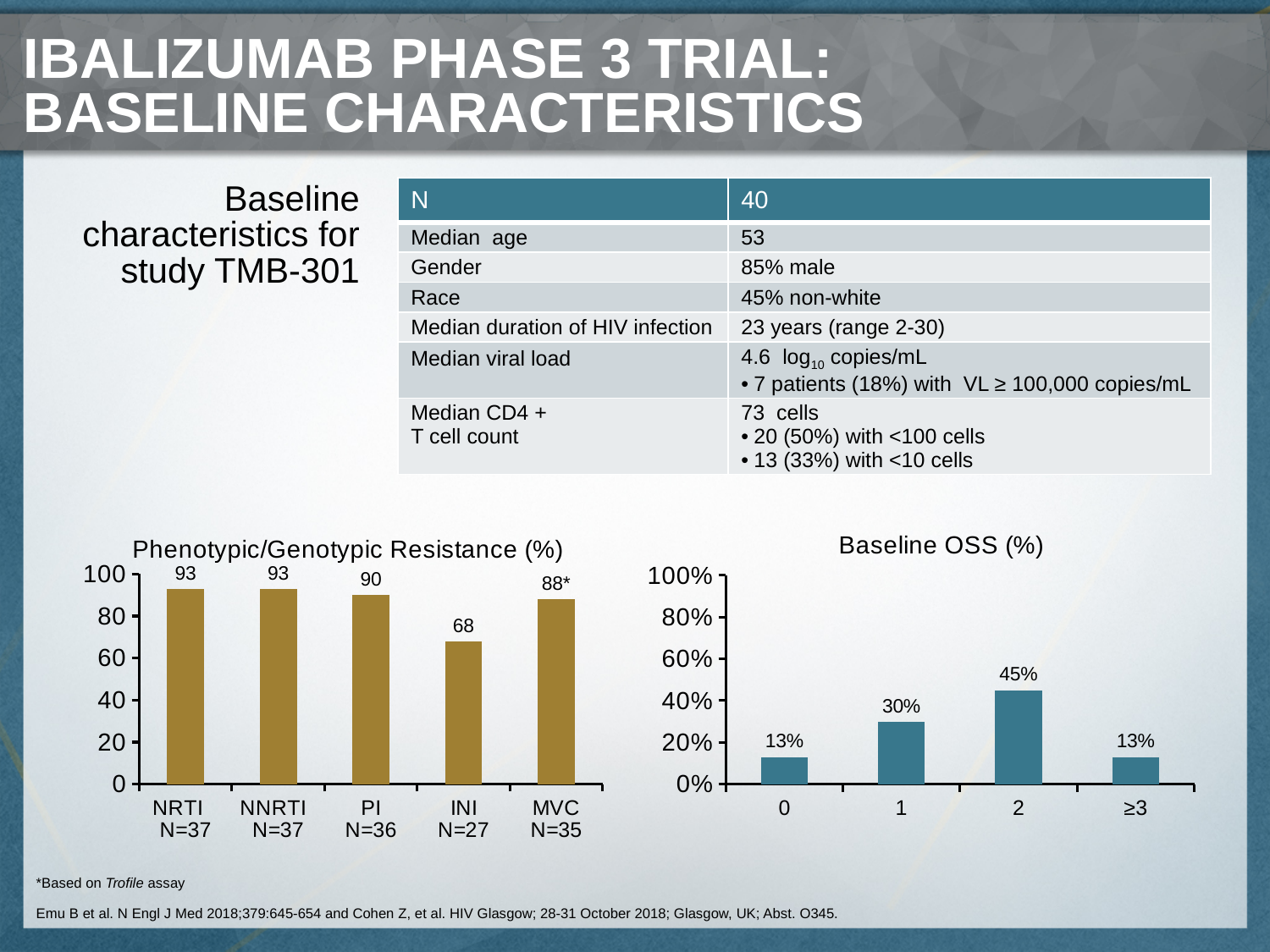
In the Phenotypic/Genotypic Resistance (%) chart, what is the N shown under the MVC label? N=35 In the Baseline OSS (%) chart, what is the value for category 2? 45% In the Baseline OSS (%) chart, which is larger, the value for category 1 or the value for ≥3? 1 In the Phenotypic/Genotypic Resistance (%) chart, which category has the lowest value? INI In the Baseline OSS (%) chart, what is the difference between the values for category 2 and category 1? 15% In the Baseline OSS (%) chart, what is the value for category 1? 30% In the Baseline OSS (%) chart, which category has the highest value? 2 In the Phenotypic/Genotypic Resistance (%) chart, how many categories are shown on the x axis? 5 In the Phenotypic/Genotypic Resistance (%) chart, what is the difference between the values for NRTI and INI? 25 What kind of chart is the Baseline OSS (%) chart? Bar chart In the Phenotypic/Genotypic Resistance (%) chart, what is the value for INI? 68 In the Phenotypic/Genotypic Resistance (%) chart, what is the value for PI? 90